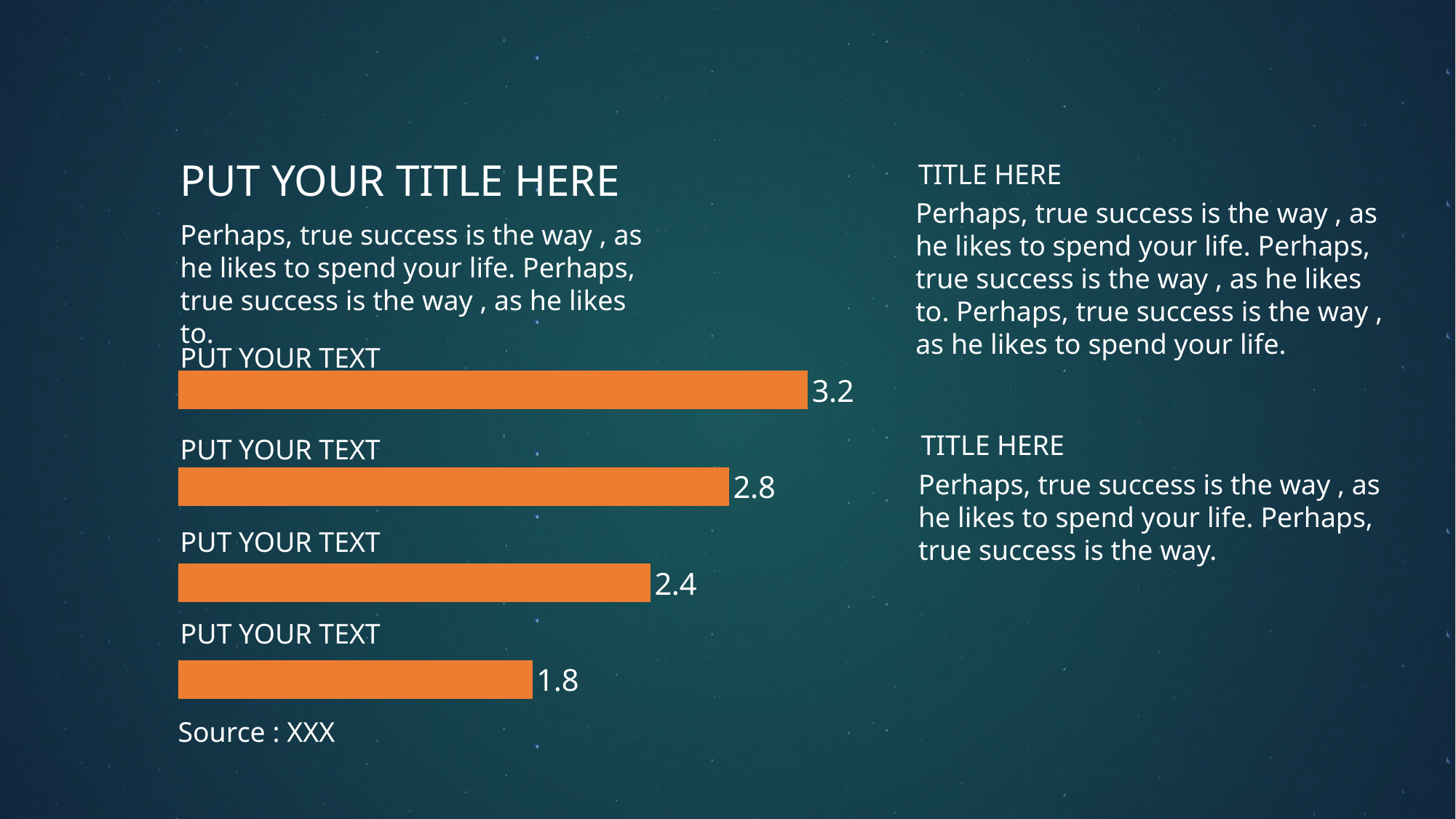
Which is larger, the value of the second bar from the top or the value of the third bar from the top? The second bar from the top (2.8) What is the value of the bottom bar in the chart? 1.8 What is the value of the top bar in the chart? 3.2 What is the value of the third bar from the top in the chart? 2.4 How many bars are shown in the chart? 4 What is the difference between the second bar (2.8) and the third bar (2.4)? 0.4 Which bar has the lowest value in the chart? The bottom bar (1.8) What is the value of the second bar from the top in the chart? 2.8 What type of chart is shown on the slide? Bar chart Which bar has the highest value in the chart? The top bar (3.2) What colour are the bars in the chart? Orange What is the difference between the top bar and the bottom bar values? 1.4